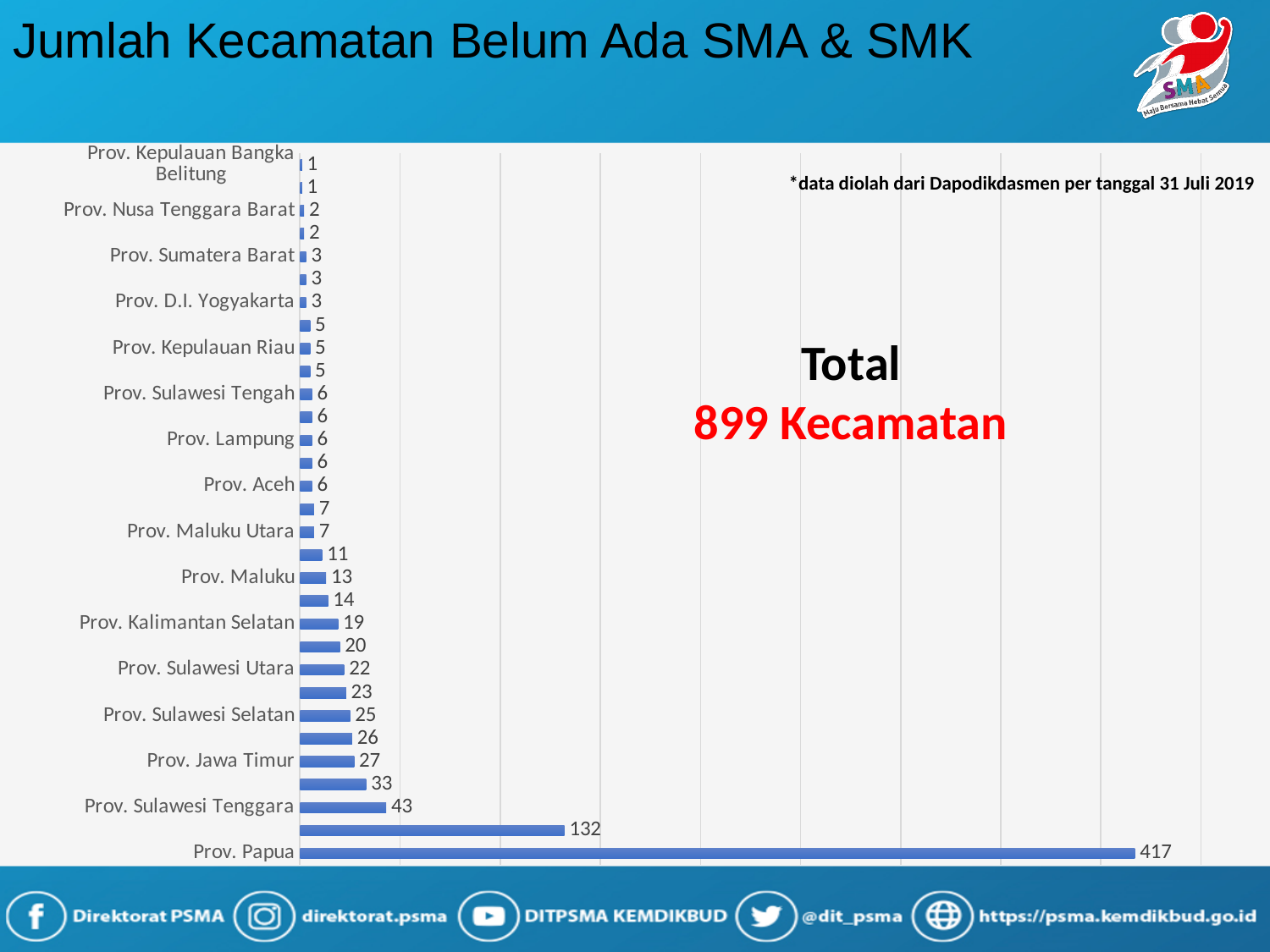
What is the value for Prov. Kepulauan Riau? 5 What total is stated on the slide next to the chart? 899 Kecamatan What is the value for Prov. Maluku? 13 What is the difference between the values for Prov. Papua and Prov. Sulawesi Tenggara? 374 What is the difference between the values for Prov. Maluku and Prov. Maluku Utara? 6 What type of chart is shown on the slide? bar chart What is the title of the slide containing the chart? Jumlah Kecamatan Belum Ada SMA & SMK What is the value for Prov. Sulawesi Tenggara? 43 Which province has the highest value in the chart? Prov. Papua What is the value for Prov. Jawa Timur? 27 What is the value for Prov. Papua? 417 Which has a larger value, Prov. Kalimantan Selatan or Prov. Sulawesi Utara? Prov. Sulawesi Utara